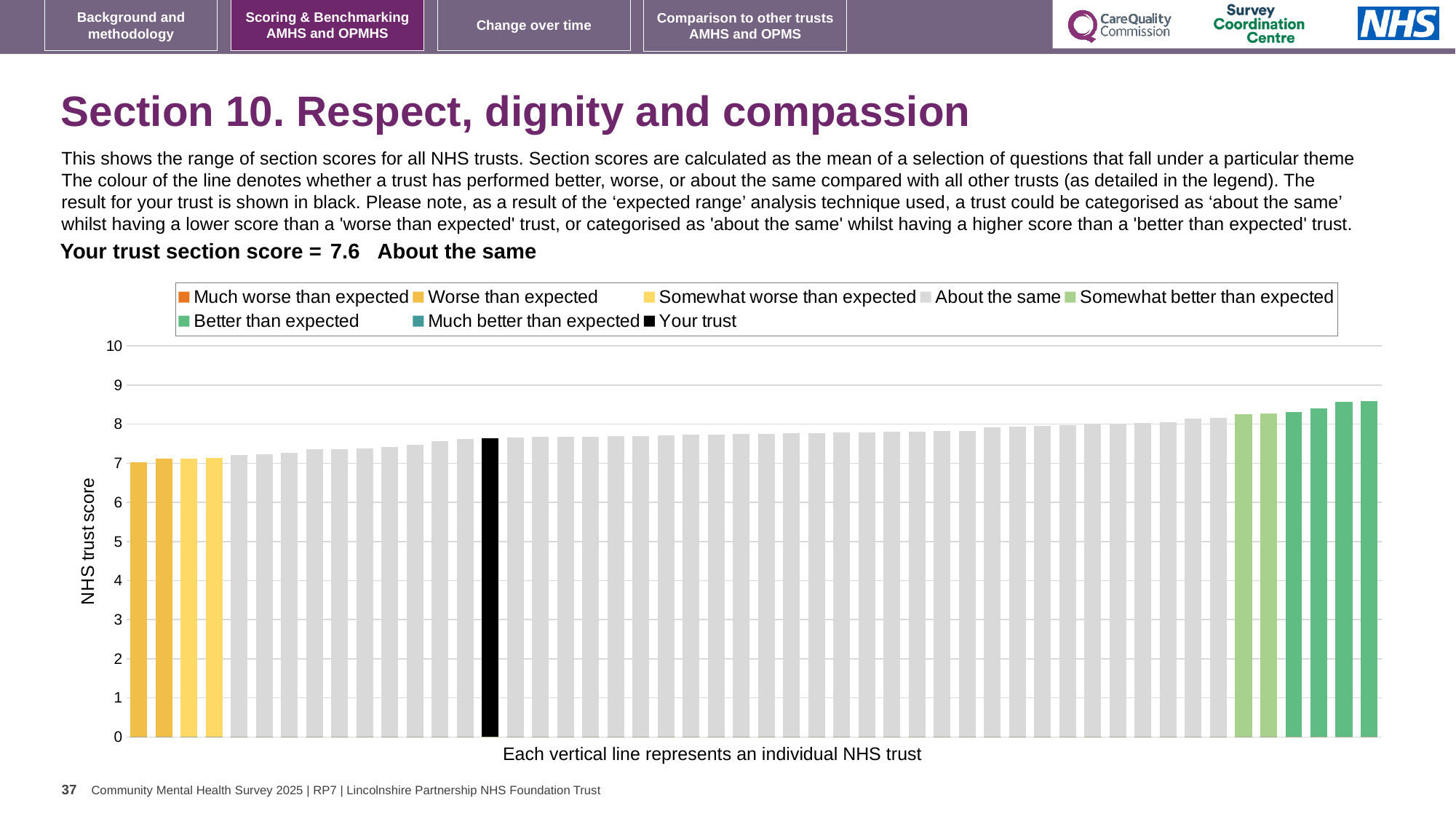
Is the value of the leftmost bar greater or less than 8? less Is the value of the black 'Your trust' bar greater or less than 7? greater Do the bar values rise or fall from left to right along the x axis? rise Which legend category do the tallest bars on the chart belong to? Better than expected What category is your trust placed in according to the text above the chart? About the same Is the value of the rightmost bar greater or less than 8? greater How many entries does the chart legend list? 8 What kind of chart is shown on the slide? bar chart What is the label on the vertical axis of the chart? NHS trust score What is the section score for your trust shown on the slide? 7.6 Which is larger, the leftmost bar or the rightmost bar? the rightmost bar